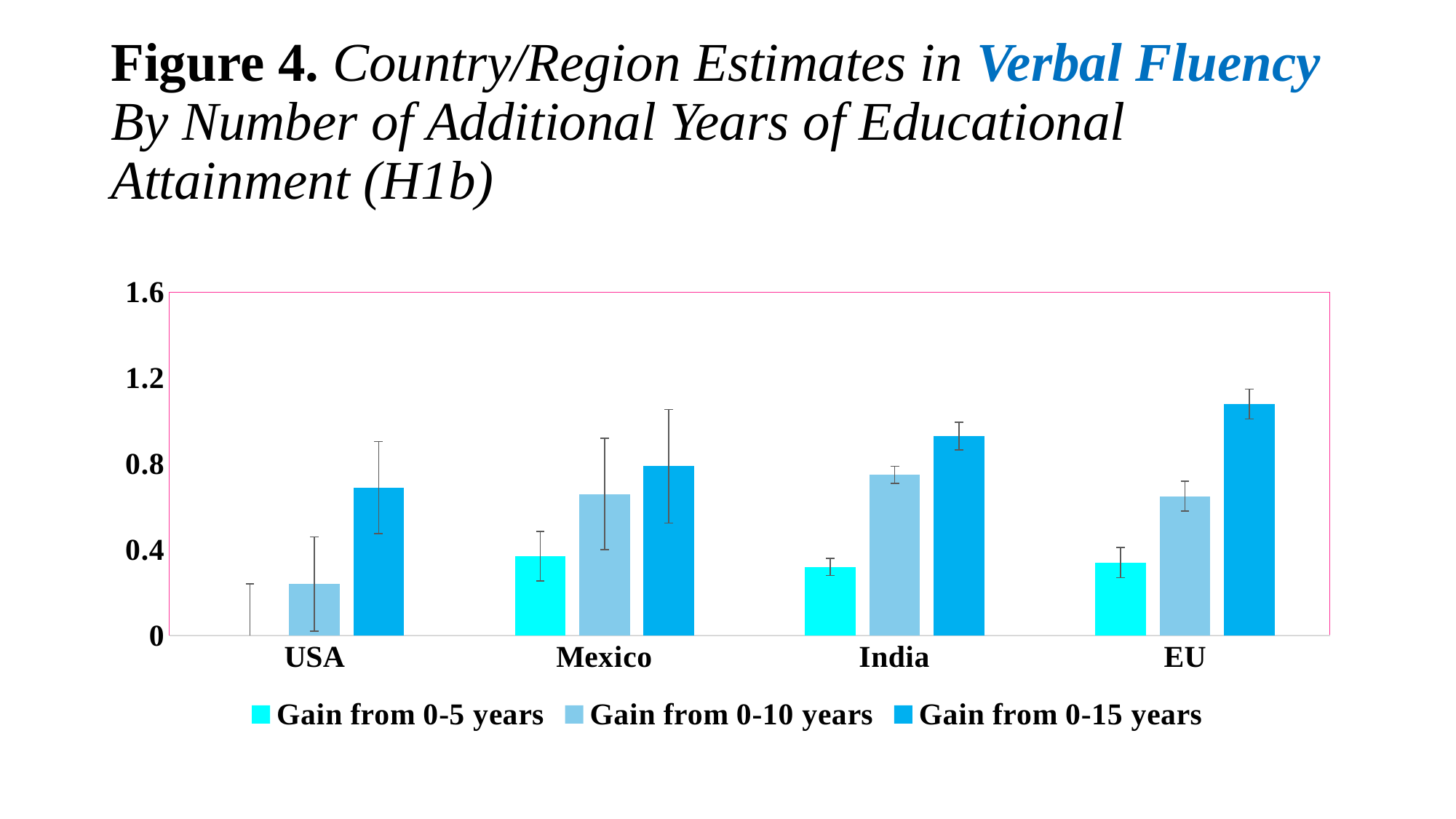
Which country/region has the highest value for Gain from 0-15 years? EU Which country/region has the lowest value for Gain from 0-10 years? USA What kind of chart is shown on the slide? bar chart How many series does the legend list? 3 Which country/region has the highest value for Gain from 0-10 years? India Is the value for Gain from 0-10 years in the USA greater or less than 0.4? less Which series is shown in the lightest (cyan) colour in the legend? Gain from 0-5 years Is the value for Gain from 0-10 years in Mexico greater or less than 0.4? greater How many countries/regions are shown on the x axis? 4 Within each country/region, do the values rise or fall from Gain from 0-5 years to Gain from 0-15 years? rise Is the value for Gain from 0-15 years in the EU greater or less than 0.8? greater Which is larger: Gain from 0-15 years for India or for the EU? EU